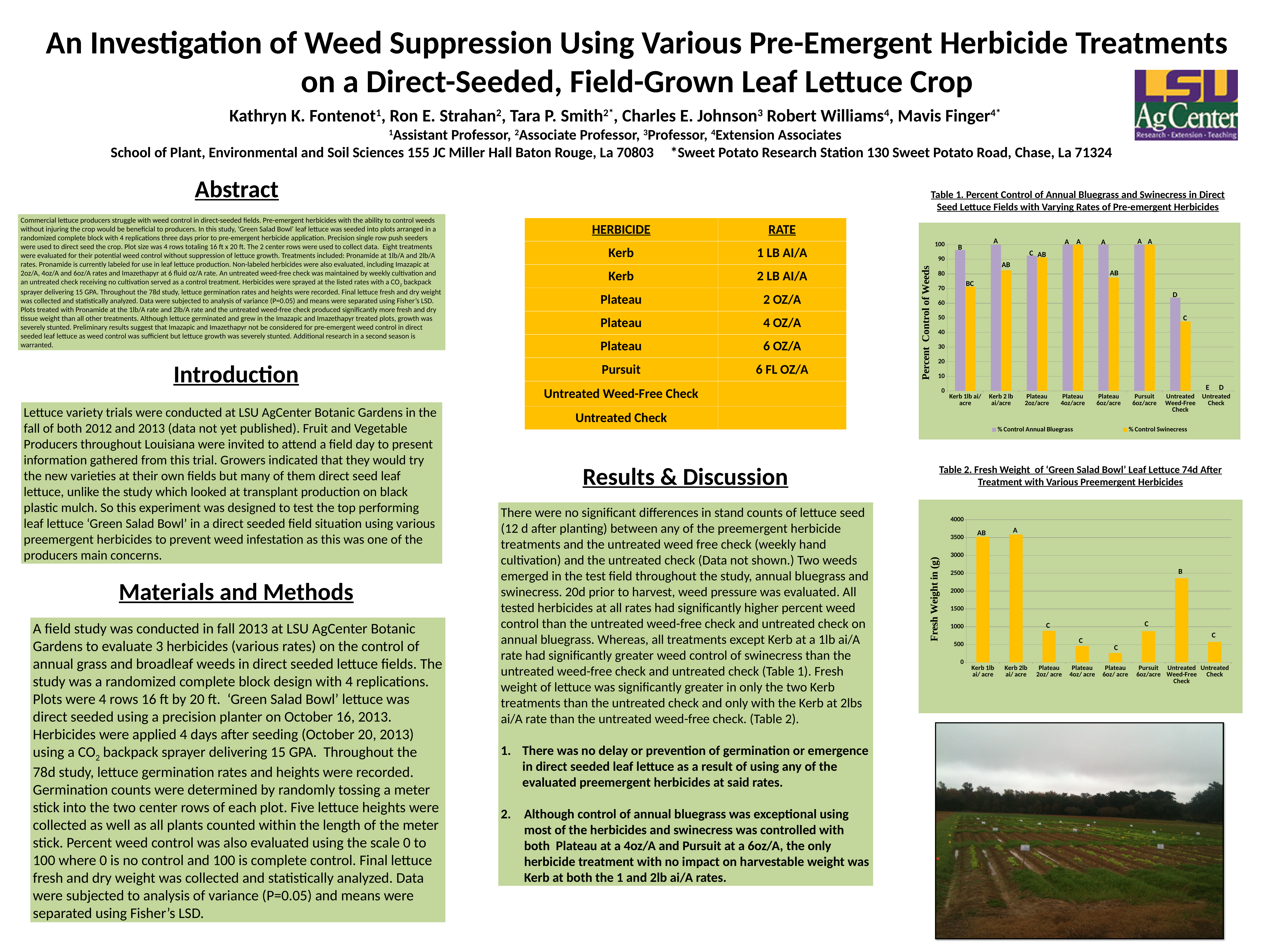
In the Table 1 chart, for Kerb 1lb ai/acre, which is larger: percent control of annual bluegrass or percent control of swinecress? % Control Annual Bluegrass In the Table 1 chart, is the percent control of annual bluegrass for the Untreated Weed-Free Check greater or less than 50? greater In the Table 2 chart, which treatment has the lowest fresh weight? Plateau 6oz/ acre What kind of chart is shown under Table 1 (Percent Control of Annual Bluegrass and Swinecress)? bar chart In the Table 1 chart, is the percent control of swinecress for Plateau 6oz/acre greater or less than 90? less In the Table 2 chart, which has the larger fresh weight: Untreated Weed-Free Check or Untreated Check? Untreated Weed-Free Check In the Table 1 chart, which treatment has the lowest percent control of swinecress? Untreated Check What is the y-axis label of the Table 2 chart (Fresh Weight of 'Green Salad Bowl' Leaf Lettuce)? Fresh Weight in (g) In the Table 1 chart, what is the percent control of annual bluegrass for the Untreated Check? 0 How many series does the legend of the Table 1 chart list? 2 In the Table 2 chart, is the fresh weight for the Untreated Weed-Free Check greater or less than 2000? greater How many treatment categories are shown on the x axis of the Table 1 chart? 8